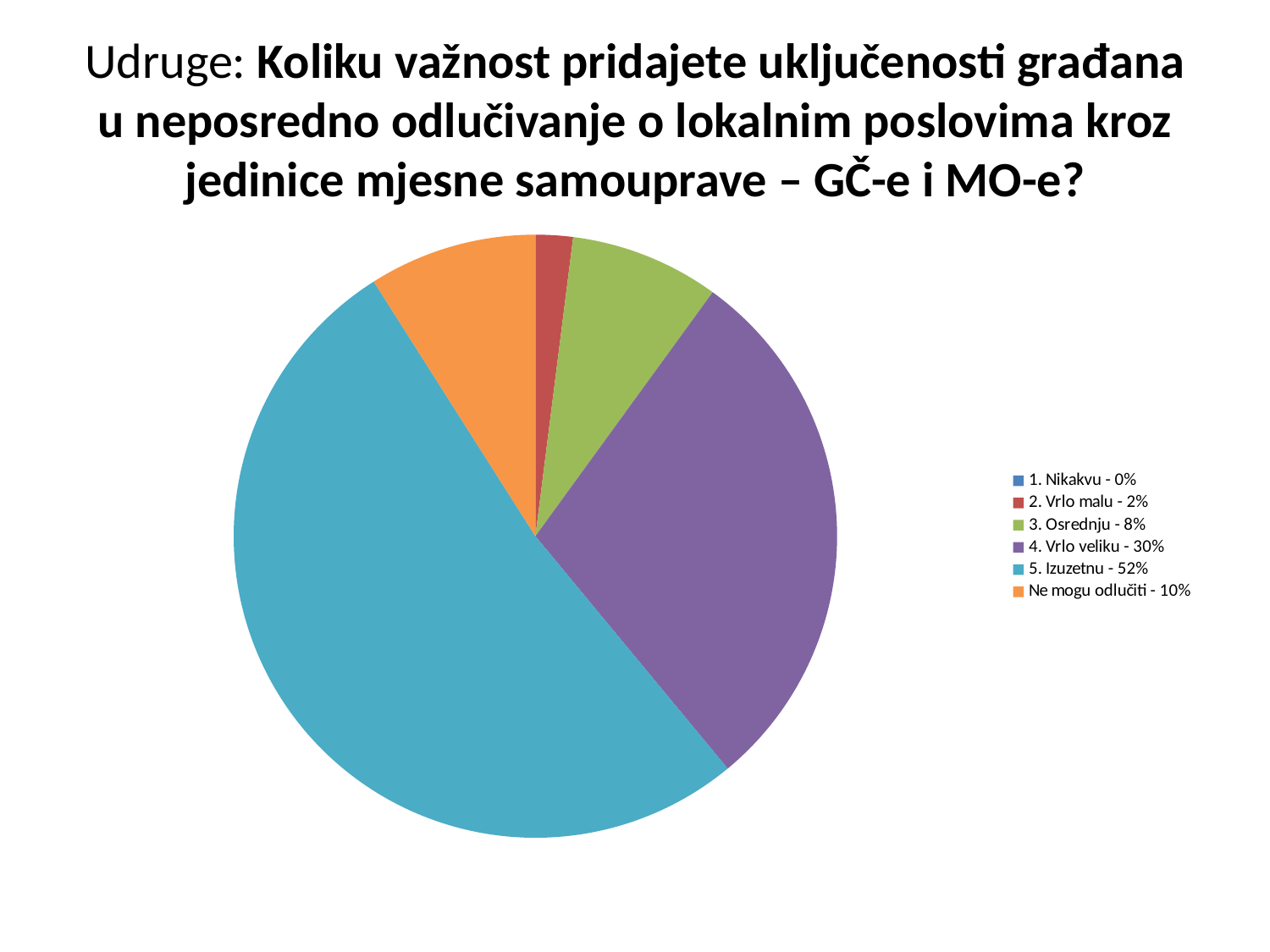
What is the value for "Ne mogu odlučiti"? 10% Which is larger, the share for "Ne mogu odlučiti" or the share for "3. Osrednju"? Ne mogu odlučiti What share of the pie does "5. Izuzetnu" have? 52% What is the difference between the shares of "5. Izuzetnu" and "4. Vrlo veliku"? 22% Which category has the largest share of the pie? 5. Izuzetnu What share of the pie does "4. Vrlo veliku" have? 30% Which category has the smallest share of the pie? 1. Nikakvu What is the value for "2. Vrlo malu"? 2% What is the value for "3. Osrednju"? 8% What colour is the slice for "4. Vrlo veliku"? purple What kind of chart is shown on the slide? pie chart How many categories does the legend list? 6